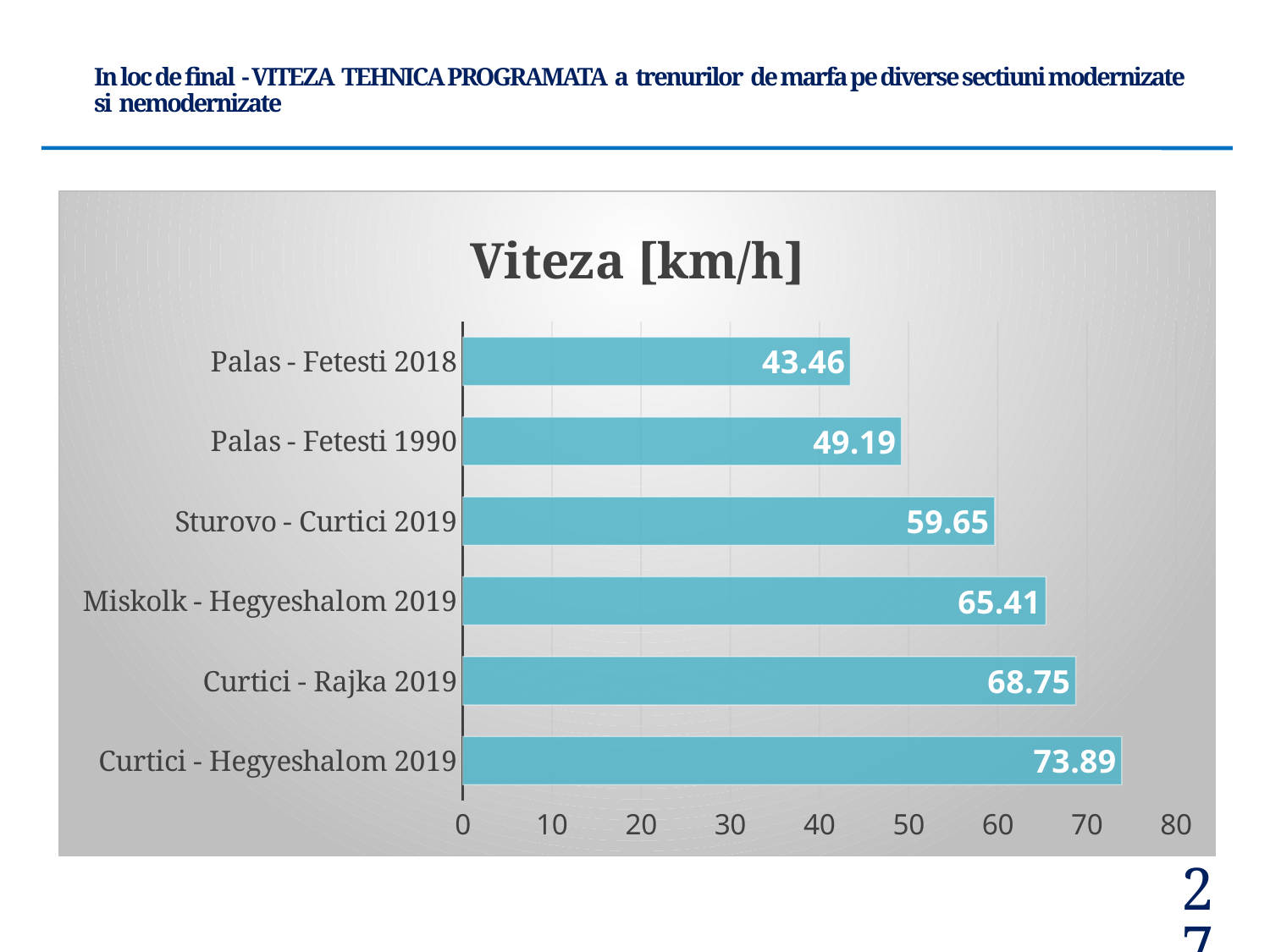
Which is larger, the value for Miskolk - Hegyeshalom 2019 or the value for Sturovo - Curtici 2019? Miskolk - Hegyeshalom 2019 What is the difference between the values for Palas - Fetesti 1990 and Palas - Fetesti 2018? 5.73 What is the difference between the values for Curtici - Hegyeshalom 2019 and Curtici - Rajka 2019? 5.14 Which category has the highest value? Curtici - Hegyeshalom 2019 What kind of chart is shown on the slide? bar chart What is the value for Sturovo - Curtici 2019? 59.65 Which category has the lowest value? Palas - Fetesti 2018 What is the value for Palas - Fetesti 1990? 49.19 What is the title of the chart? Viteza [km/h] How many categories are shown in the chart? 6 Is the value for Curtici - Rajka 2019 greater or less than 60? greater What is the value for Curtici - Hegyeshalom 2019? 73.89